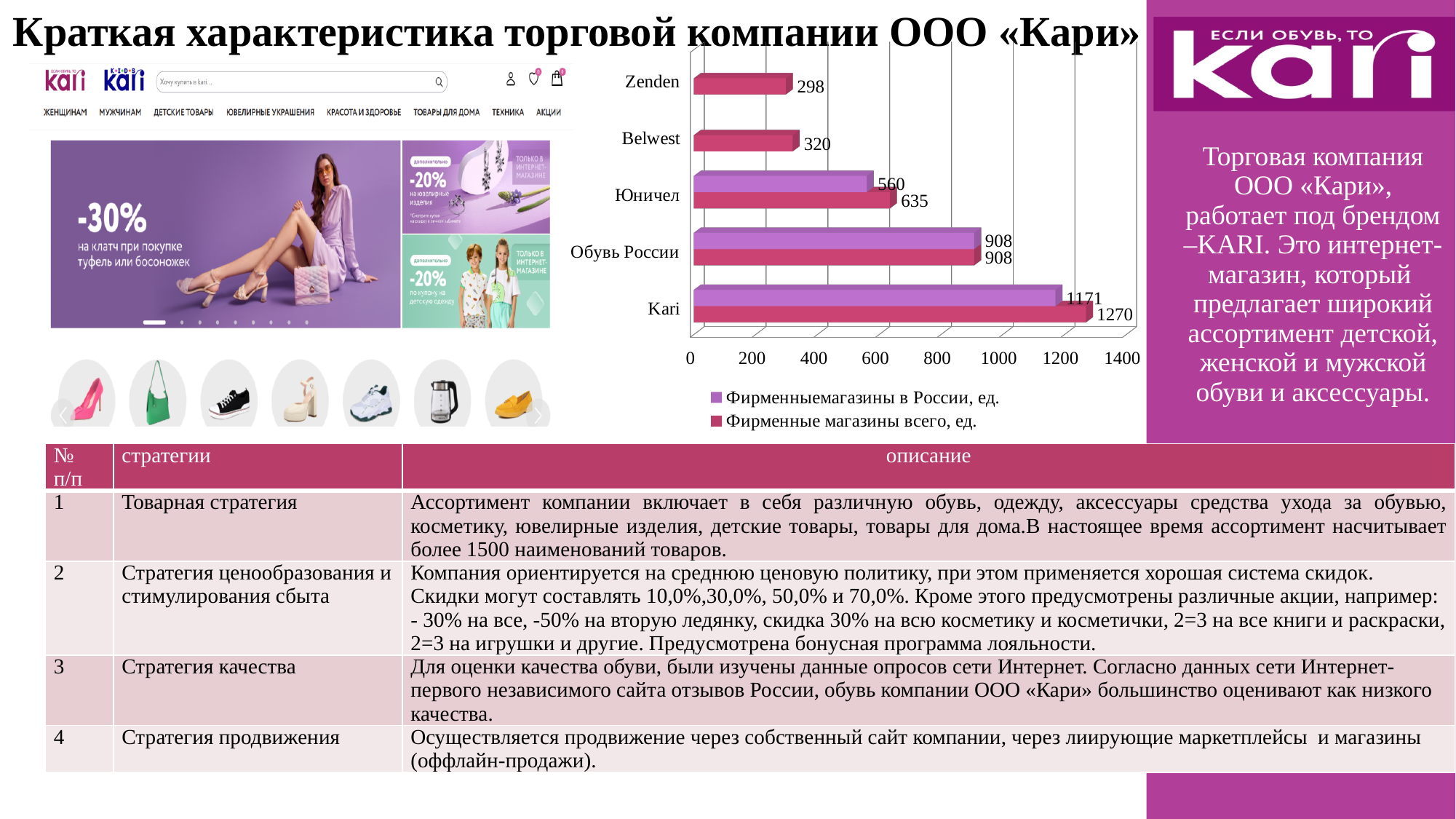
What is the value of 'Фирменные магазины всего, ед.' for Zenden? 298 What is the value of 'Фирменныемагазины в России, ед.' for Kari? 1171 Which company has the highest value for 'Фирменные магазины всего, ед.'? Kari Which company has the lowest value for 'Фирменные магазины всего, ед.'? Zenden Which is larger for Юничел: 'Фирменные магазины всего, ед.' or 'Фирменныемагазины в России, ед.'? Фирменные магазины всего, ед. How many categories (companies) are shown on the chart's vertical axis? 5 What is the value of 'Фирменные магазины всего, ед.' for Kari? 1270 How many series does the chart legend list? 2 What is the value of 'Фирменные магазины всего, ед.' for Belwest? 320 What kind of chart is shown on the slide? bar chart What is the value of 'Фирменныемагазины в России, ед.' for Юничел? 560 What is the difference between 'Фирменные магазины всего, ед.' and 'Фирменныемагазины в России, ед.' for Kari? 99